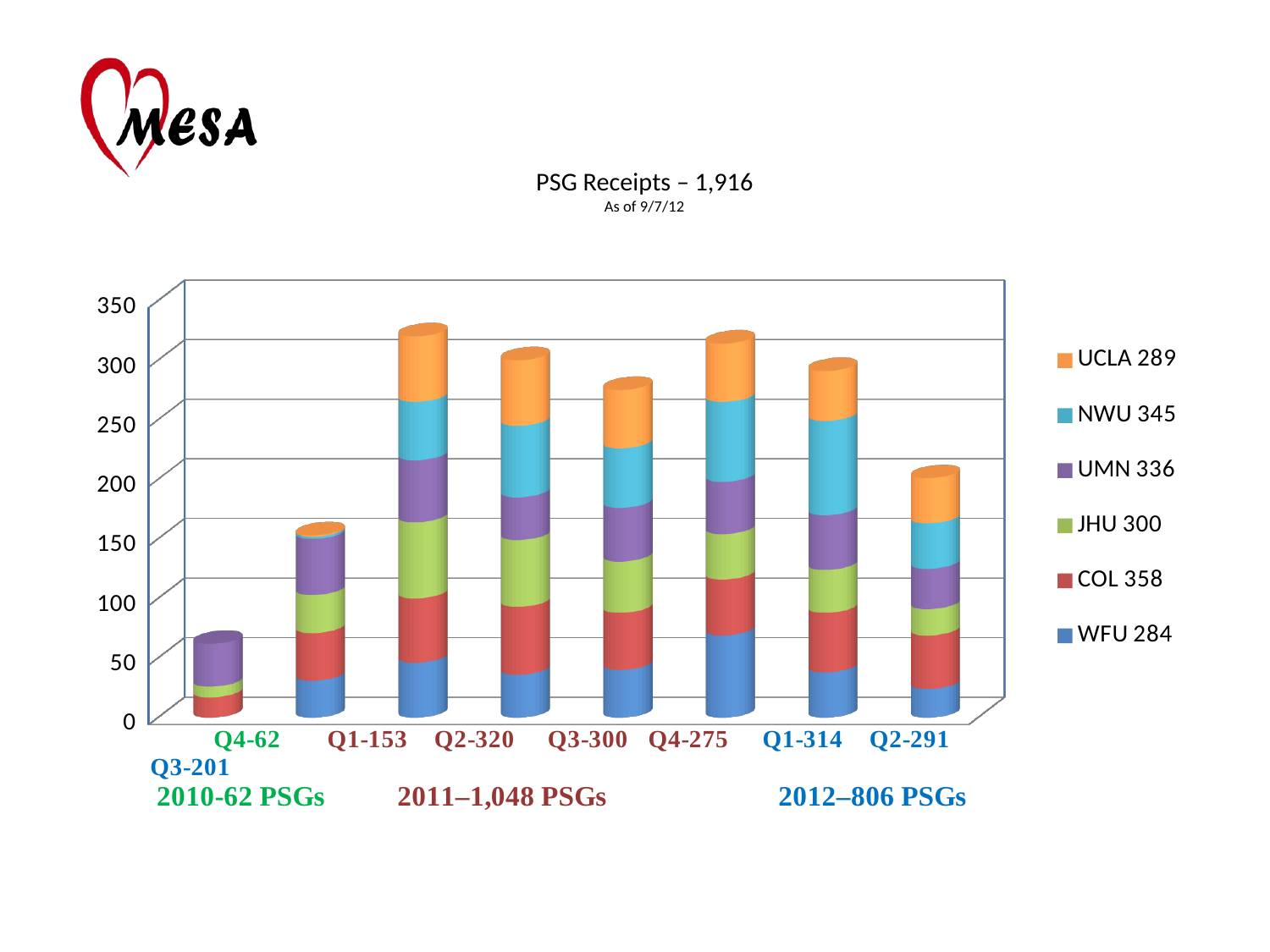
What is the total of the stacked bar labelled Q2-320? 320 Which bar has the larger total, Q1-314 or Q2-291? Q1-314 What is the title of the chart? PSG Receipts – 1,916 Is the total of the Q4-275 bar greater or less than 250? greater According to the legend, what is the total number of PSGs for NWU? 345 Which quarterly bar has the lowest total? Q4-62 What kind of chart is shown on the slide? bar chart How many quarterly bars are plotted in the chart? 7 How many series does the legend list? 6 Which quarterly bar has the highest total? Q2-320 According to the legend, which site has the highest total number of PSGs? COL 358 What is the difference between the totals of the Q2-320 bar and the Q3-300 bar? 20